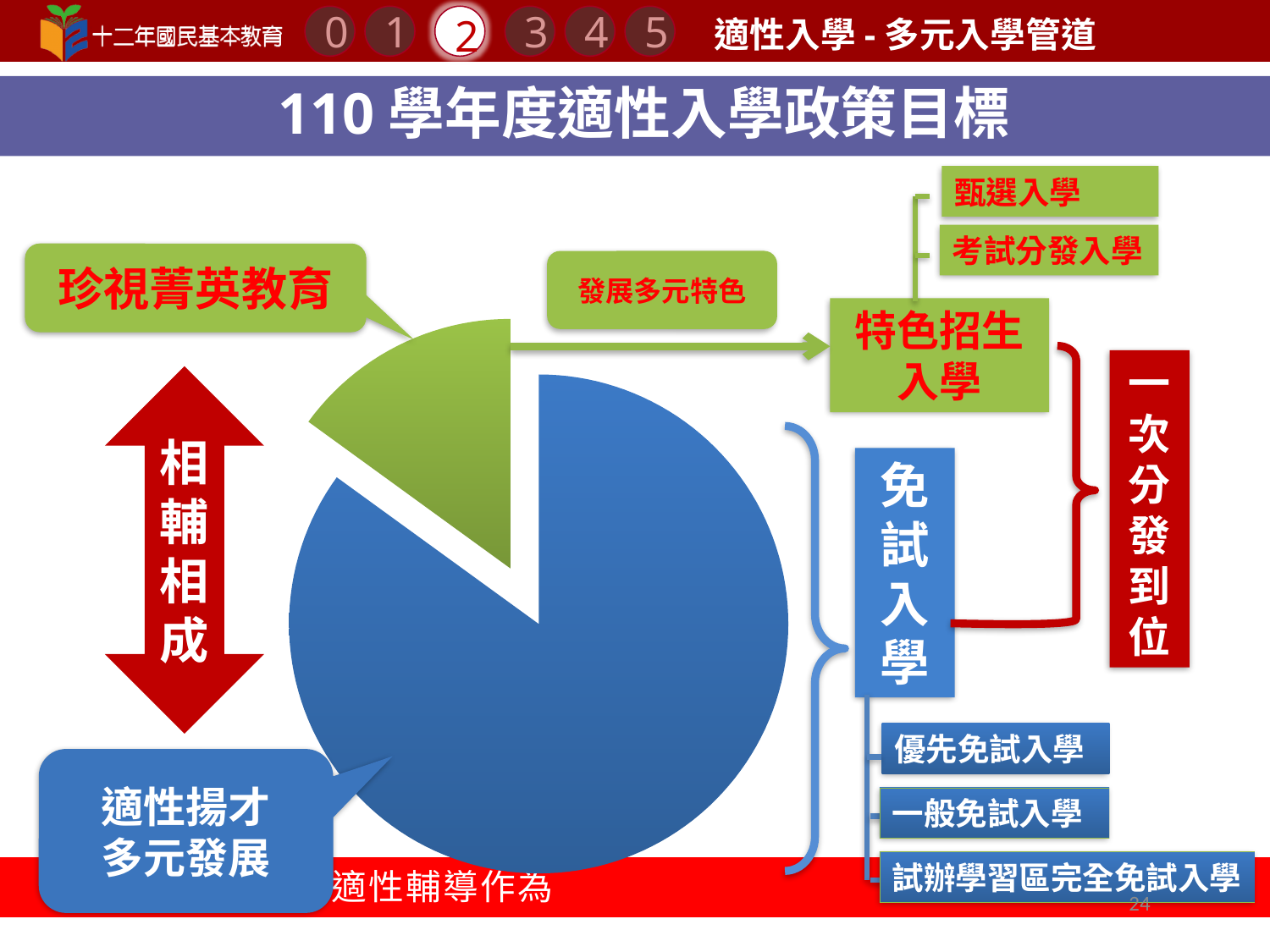
How many slices does the pie chart have? 2 What is the title of the slide containing the pie chart? 110 學年度適性入學政策目標 Which category has the smallest slice in the pie chart? 特色招生入學 What kind of chart is shown on the slide? pie chart What colour is the 免試入學 slice of the pie chart? blue Which category has the largest slice in the pie chart? 免試入學 Is the 免試入學 slice more or less than half of the pie? more Which slice of the pie chart is larger, 免試入學 or 特色招生入學? 免試入學